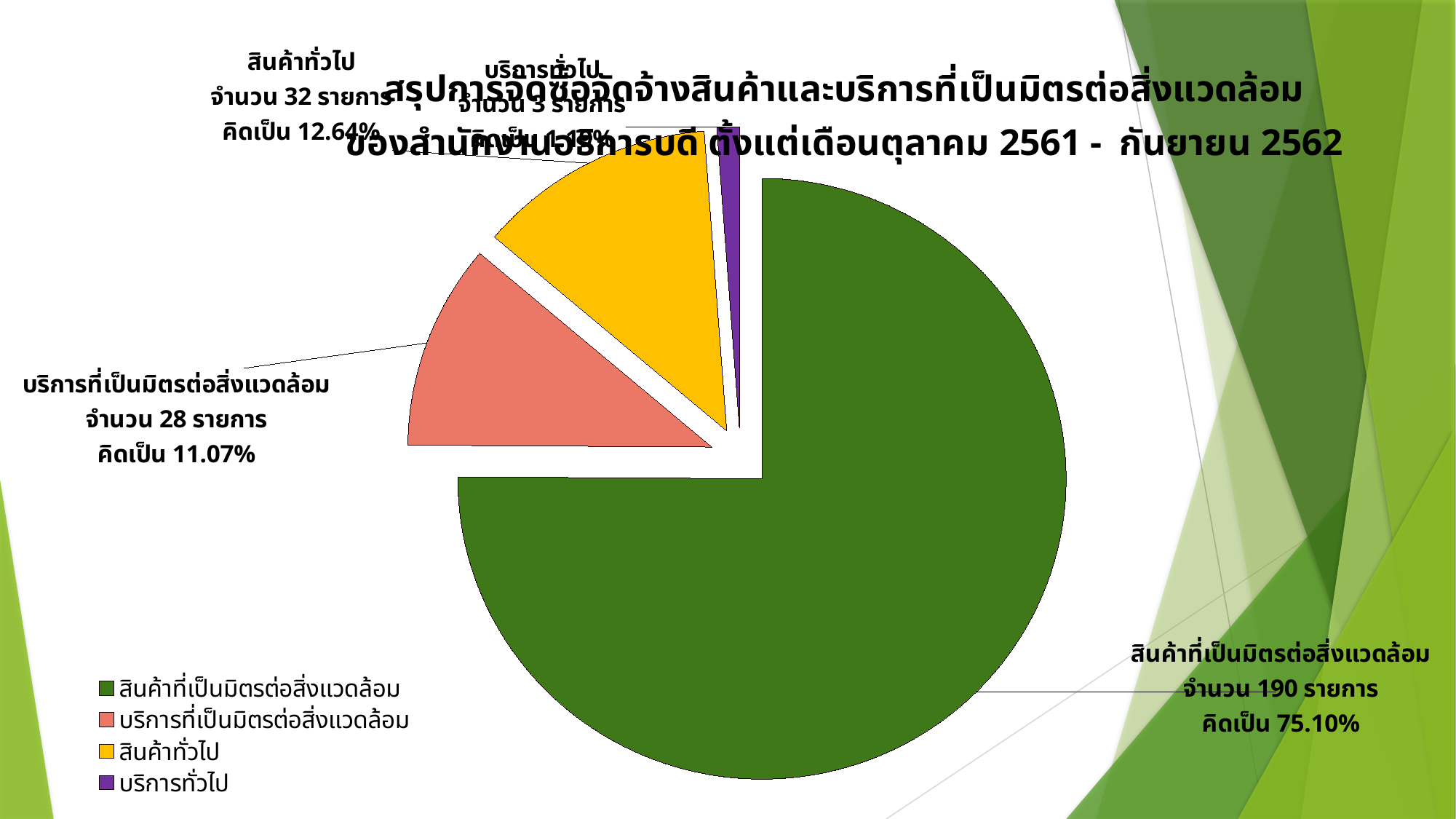
How many items (รายการ) are shown for บริการที่เป็นมิตรต่อสิ่งแวดล้อม? 28 รายการ What percentage share is shown for สินค้าทั่วไป? 12.64% Which category has the smallest slice of the pie? บริการทั่วไป Which has more items: สินค้าทั่วไป or บริการที่เป็นมิตรต่อสิ่งแวดล้อม? สินค้าทั่วไป Which category has the largest slice of the pie? สินค้าที่เป็นมิตรต่อสิ่งแวดล้อม How many slices does the pie chart have? 4 How many entries does the legend list? 4 What percentage share is shown for สินค้าที่เป็นมิตรต่อสิ่งแวดล้อม? 75.10% What percentage share is shown for บริการที่เป็นมิตรต่อสิ่งแวดล้อม? 11.07% What is the difference in number of items between สินค้าที่เป็นมิตรต่อสิ่งแวดล้อม and บริการที่เป็นมิตรต่อสิ่งแวดล้อม? 162 รายการ What kind of chart is shown on the slide? Pie chart How many items (รายการ) are shown for สินค้าที่เป็นมิตรต่อสิ่งแวดล้อม? 190 รายการ